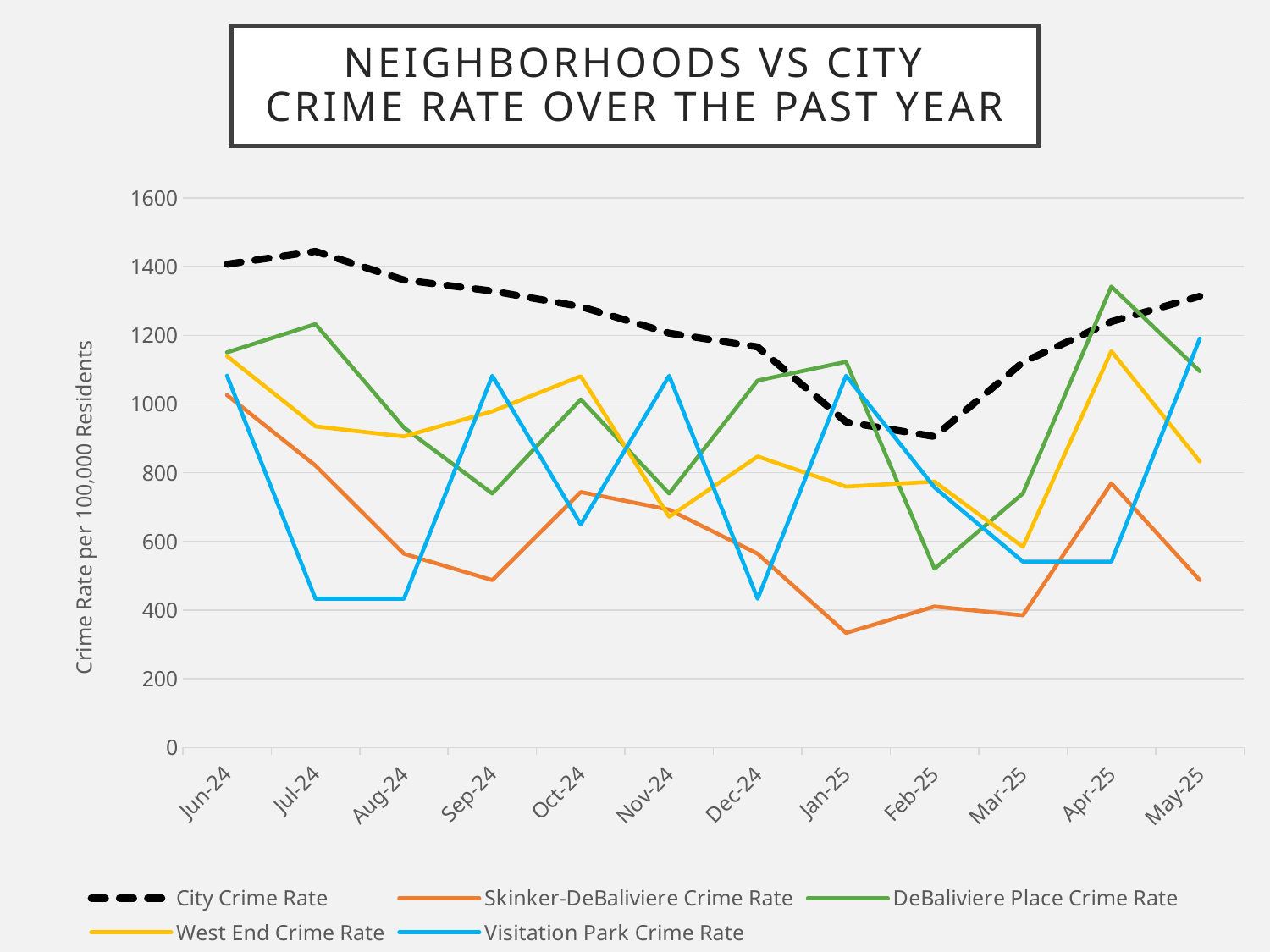
How many series does the legend list? 5 Does the City Crime Rate rise or fall from Jul-24 to Feb-25? Fall In Apr-25, which is larger: the DeBaliviere Place Crime Rate or the City Crime Rate? DeBaliviere Place Crime Rate Which series is drawn as a dashed black line? City Crime Rate Is the Visitation Park Crime Rate for Jul-24 greater or less than 600? less Is the City Crime Rate for Jul-24 greater or less than 1400? greater In which month is the City Crime Rate highest? Jul-24 How many months are plotted along the x axis? 12 Is the DeBaliviere Place Crime Rate for Apr-25 greater or less than 1200? greater In which month is the Skinker-DeBaliviere Crime Rate lowest? Jan-25 What kind of chart is shown on the slide? Line chart